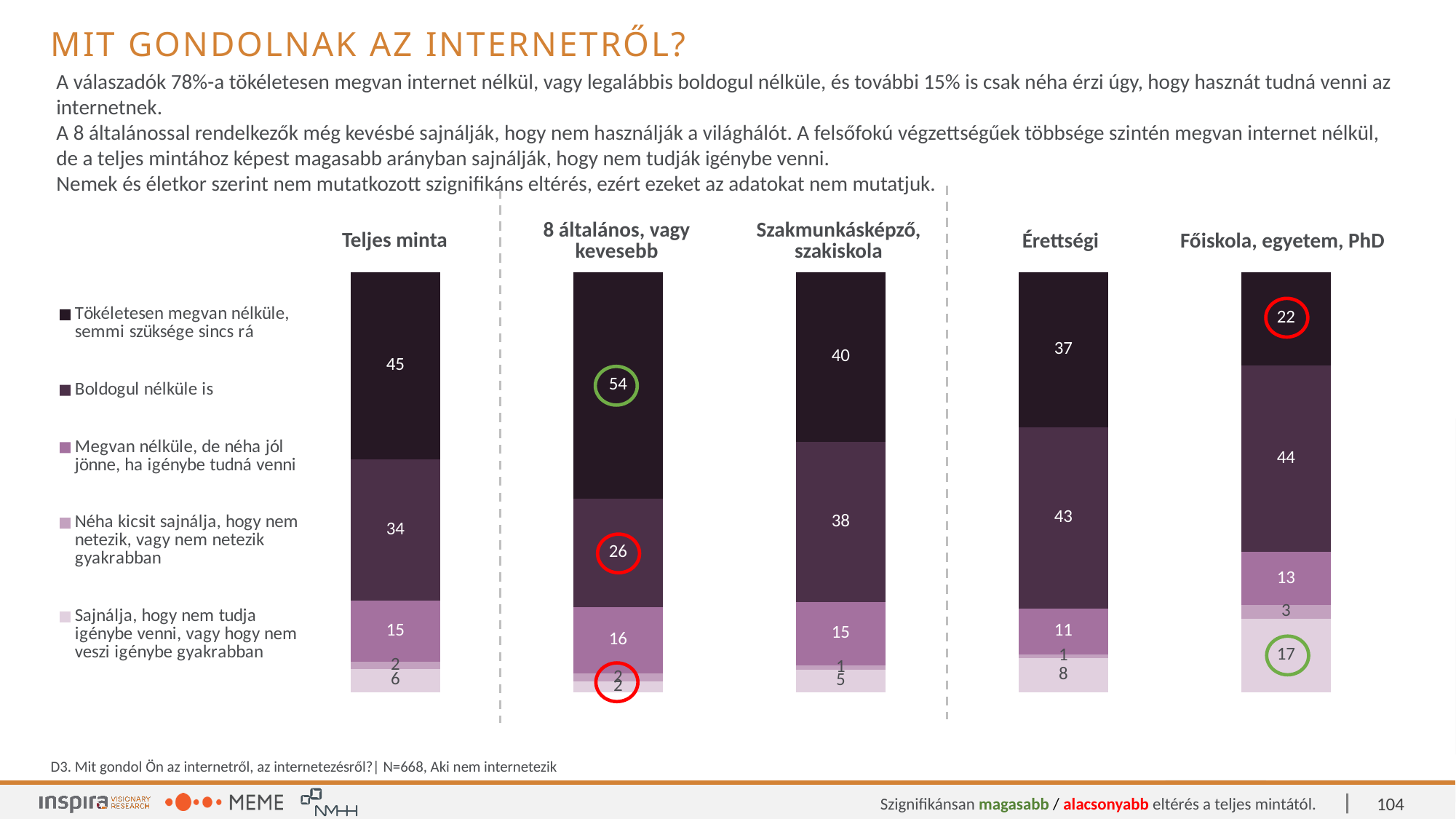
What is the difference between the 'Tökéletesen megvan nélküle' values of '8 általános, vagy kevesebb' and 'Főiskola, egyetem, PhD'? 32 Which group has the highest value for 'Tökéletesen megvan nélküle, semmi szüksége sincs rá'? 8 általános, vagy kevesebb What is the title of the slide? MIT GONDOLNAK AZ INTERNETRŐL? What is the value of 'Sajnálja, hogy nem tudja igénybe venni, vagy hogy nem veszi igénybe gyakrabban' for the 'Érettségi' bar? 8 What is the value of 'Boldogul nélküle is' for the 'Főiskola, egyetem, PhD' bar? 44 What is the total of the stacked bar for '8 általános, vagy kevesebb'? 100 How many series does the legend list? 5 Which is larger: the 'Boldogul nélküle is' value for 'Érettségi' or for 'Szakmunkásképző, szakiskola'? Érettségi What type of chart is shown on the slide? stacked bar chart What is the value of 'Tökéletesen megvan nélküle, semmi szüksége sincs rá' for the 'Teljes minta' bar? 45 How many bars (groups) are shown in the chart? 5 Which group has the lowest value for 'Tökéletesen megvan nélküle, semmi szüksége sincs rá'? Főiskola, egyetem, PhD